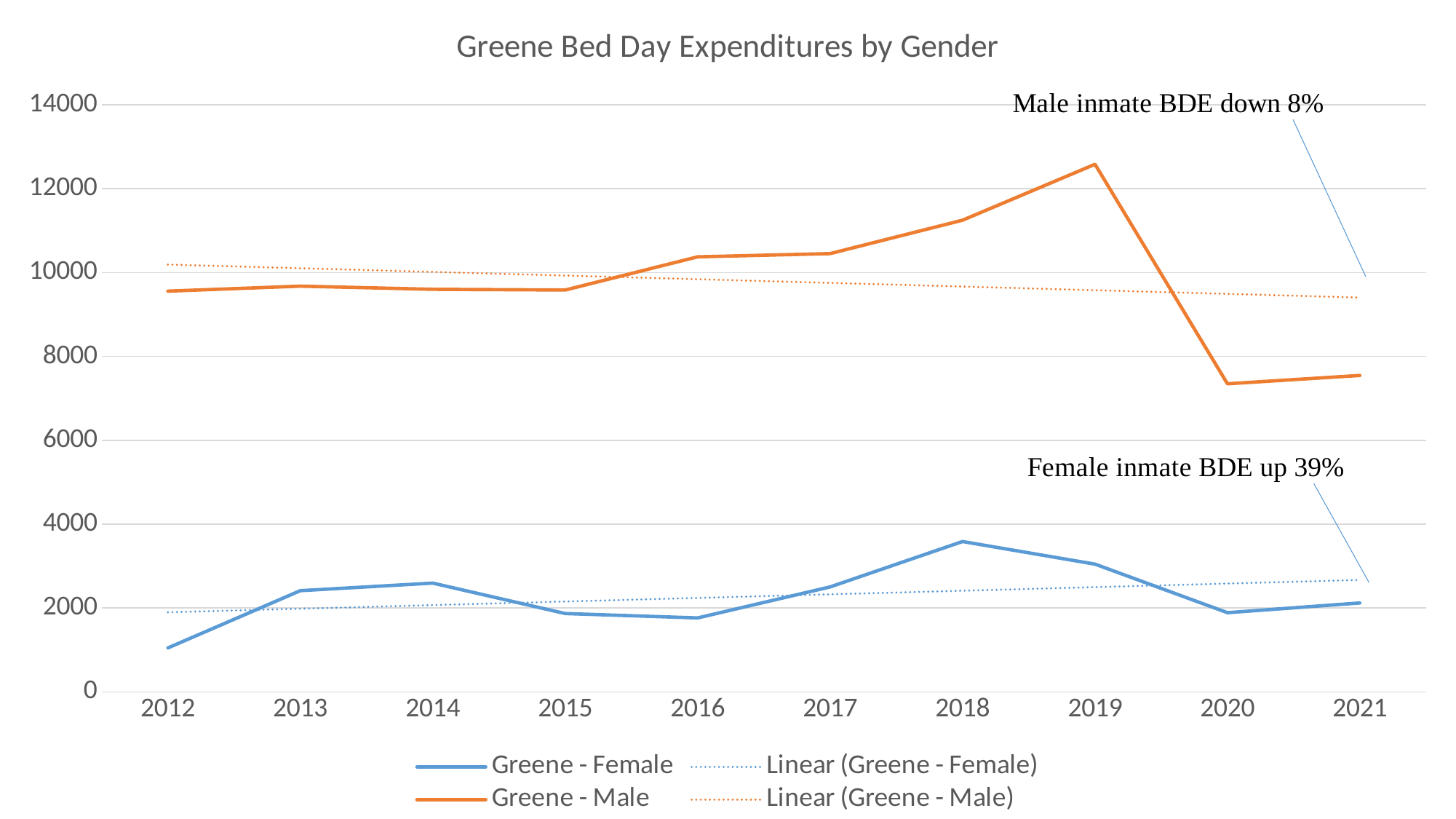
What kind of chart is shown on the slide? line chart Does the Greene - Male series rise or fall from 2019 to 2020? fall Is the Greene - Female value for 2012 greater or less than 2000? less Is the Greene - Male value for 2020 greater or less than 8000? less How many entries does the legend list? 4 In which year is the Greene - Male series at its lowest? 2020 Is the Greene - Male value for 2019 greater or less than 12000? greater Which is larger for Greene - Female: the value in 2018 or the value in 2014? 2018 In which year is the Greene - Male series at its highest? 2019 In which year is the Greene - Female series at its lowest? 2012 How many years are shown along the x axis? 10 In which year is the Greene - Female series at its highest? 2018